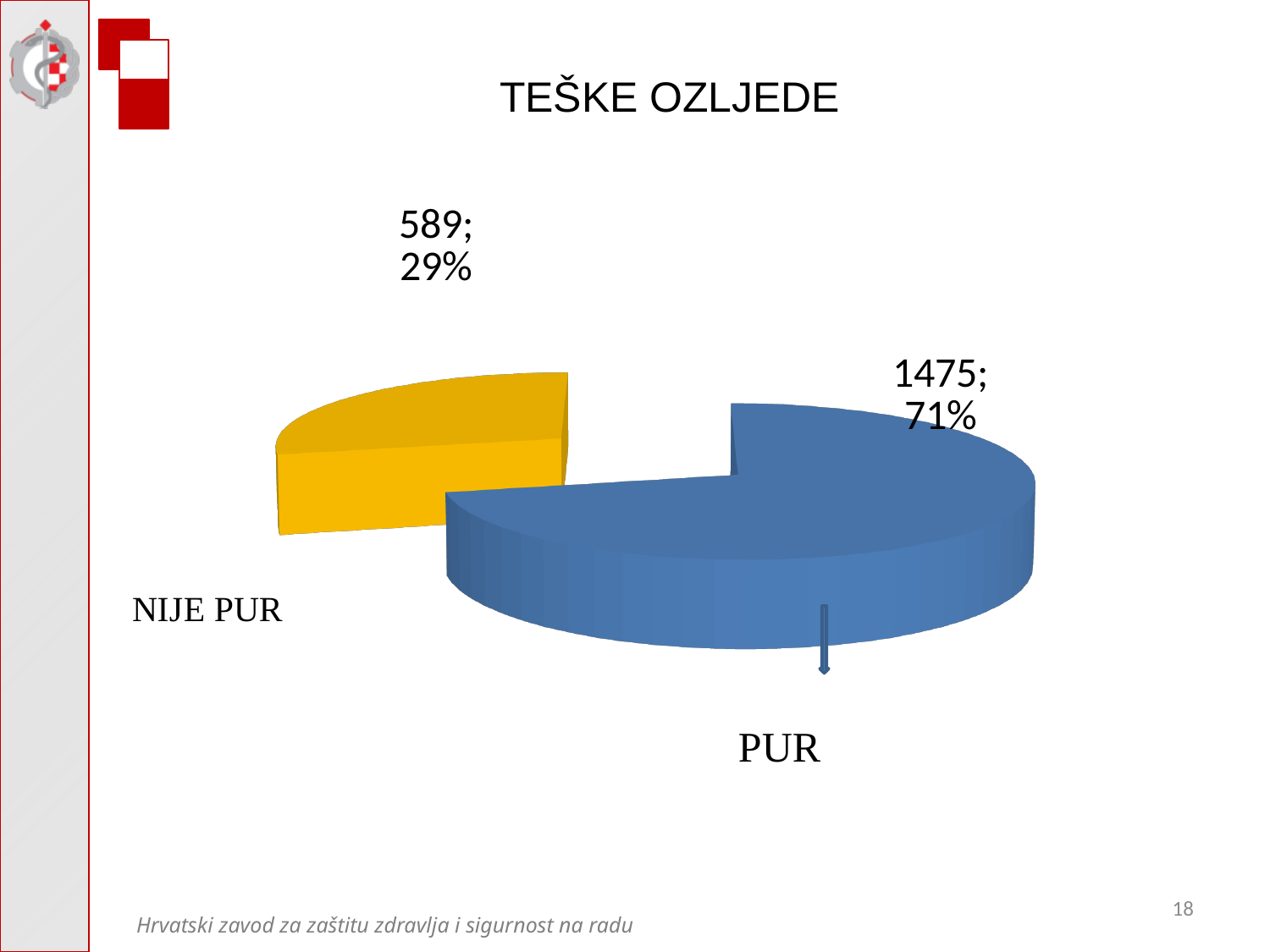
What is the title of the chart? TEŠKE OZLJEDE Which category has the largest slice? PUR What share of the pie does NIJE PUR represent? 29% How many slices does the pie chart have? 2 Which category has the smallest slice? NIJE PUR What is the value for PUR? 1475 What share of the pie does PUR represent? 71% What is the value for NIJE PUR? 589 What colour is the slice for NIJE PUR? Yellow What is the difference between the values for PUR and NIJE PUR? 886 What type of chart is shown on the slide? Pie chart Which is larger, the value for PUR or the value for NIJE PUR? PUR